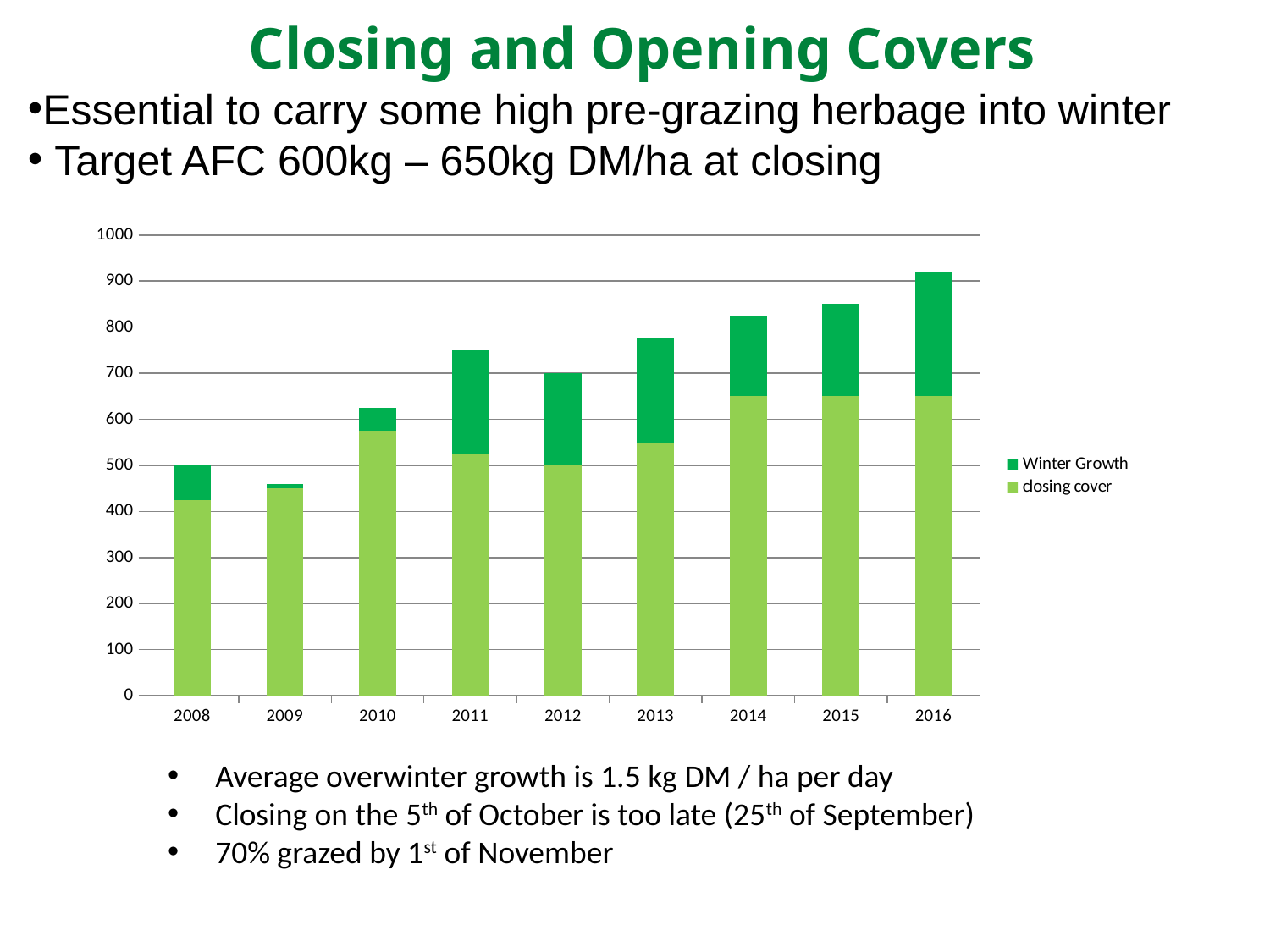
Which year has the larger total bar, 2011 or 2012? 2011 What are the two series named in the chart's legend? Winter Growth and closing cover Do the total bars rise or fall from 2013 to 2016? rise Is the total bar for 2016 greater or less than 900? greater Which year has the highest total bar (closing cover plus Winter Growth)? 2016 Is the total bar for 2009 greater or less than 500? less How many series does the chart's legend list? 2 How many years are shown along the x axis of the chart? 9 Is the closing cover value for 2008 greater or less than 500? less What kind of chart is shown on the slide? Stacked bar chart Which year has the lowest total bar (closing cover plus Winter Growth)? 2009